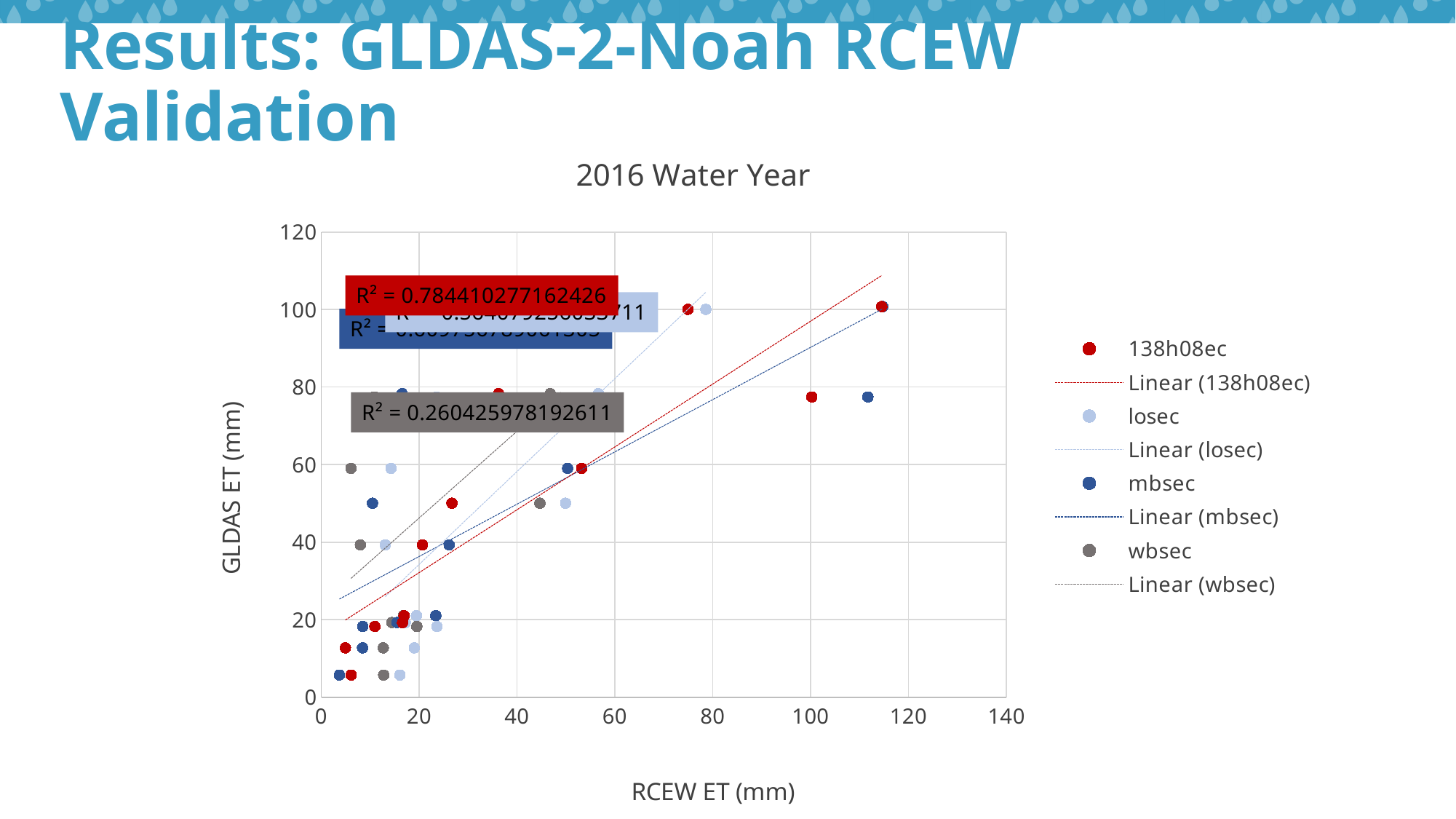
What R² value is shown in the red box? 0.784410277162426 How many point series (excluding the linear trendlines) does the legend list? 4 Is the GLDAS ET value of the 138h08ec point with the largest RCEW ET greater or less than 80? greater What is the title of the chart? 2016 Water Year Is the GLDAS ET value of the mbsec point with the largest RCEW ET greater or less than 60? greater What is the label of the x axis? RCEW ET (mm) What R² value is shown in the grey box? 0.260425978192611 Do the GLDAS ET values generally rise or fall as RCEW ET increases? rise Which series has the lowest R² value among the readable R² labels, the red series or the grey series? grey series (wbsec) Which series has the point with the largest RCEW ET value? 138h08ec What kind of chart is shown on the slide? scatter chart How many entries does the chart legend list? 8